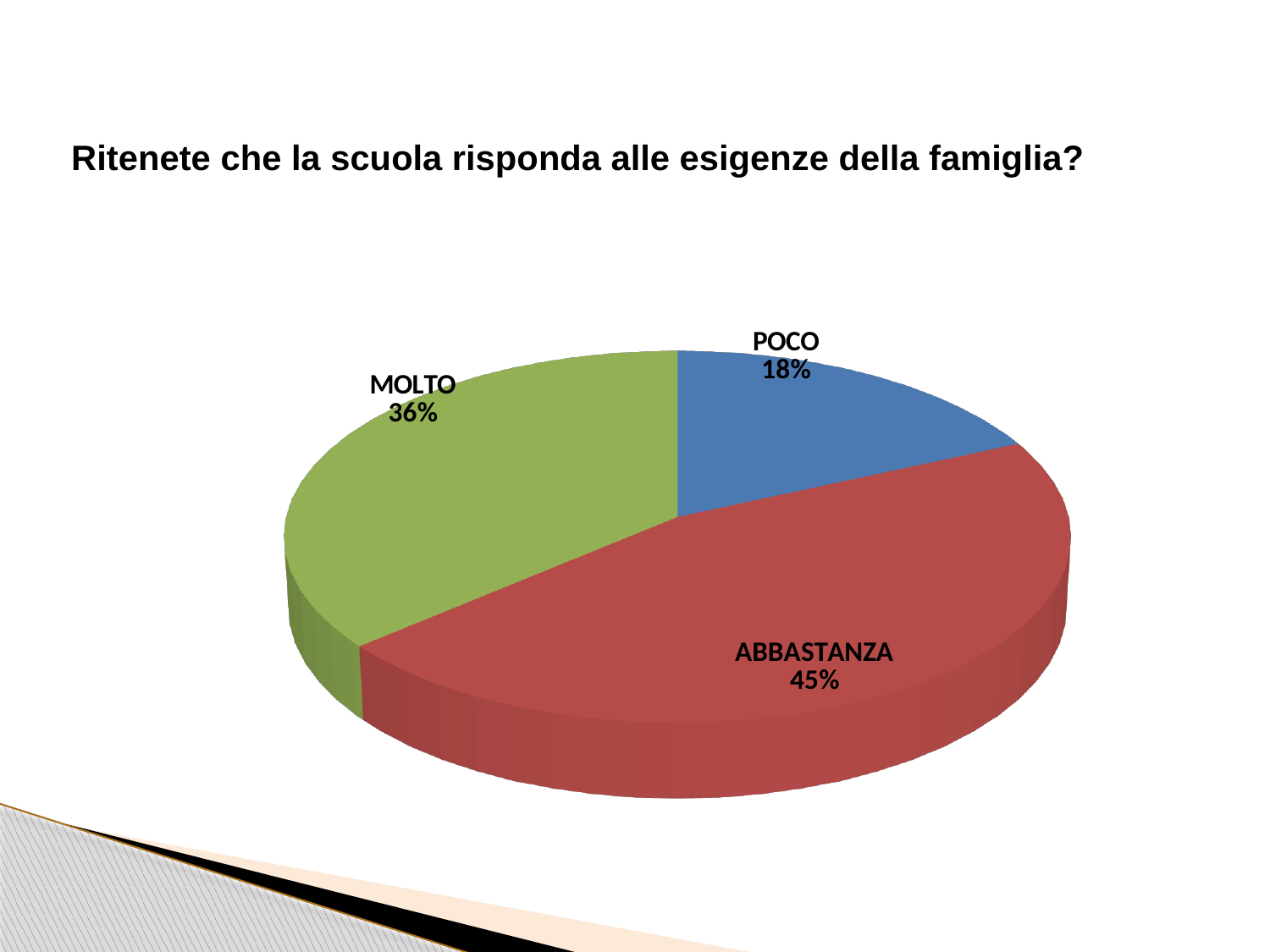
What percentage of respondents answered MOLTO? 36% What percentage of respondents answered POCO? 18% What colour is the ABBASTANZA slice? red What is the difference in percentage points between MOLTO and POCO? 18 What is the difference in percentage points between ABBASTANZA and MOLTO? 9 Which response has the smallest share of the pie? POCO Which is larger, the share for MOLTO or the share for POCO? MOLTO How many slices does the pie chart have? 3 What question is the chart answering, as shown in the slide title? Ritenete che la scuola risponda alle esigenze della famiglia? What percentage of respondents answered ABBASTANZA? 45% Which response has the largest share of the pie? ABBASTANZA What kind of chart is shown on the slide? pie chart